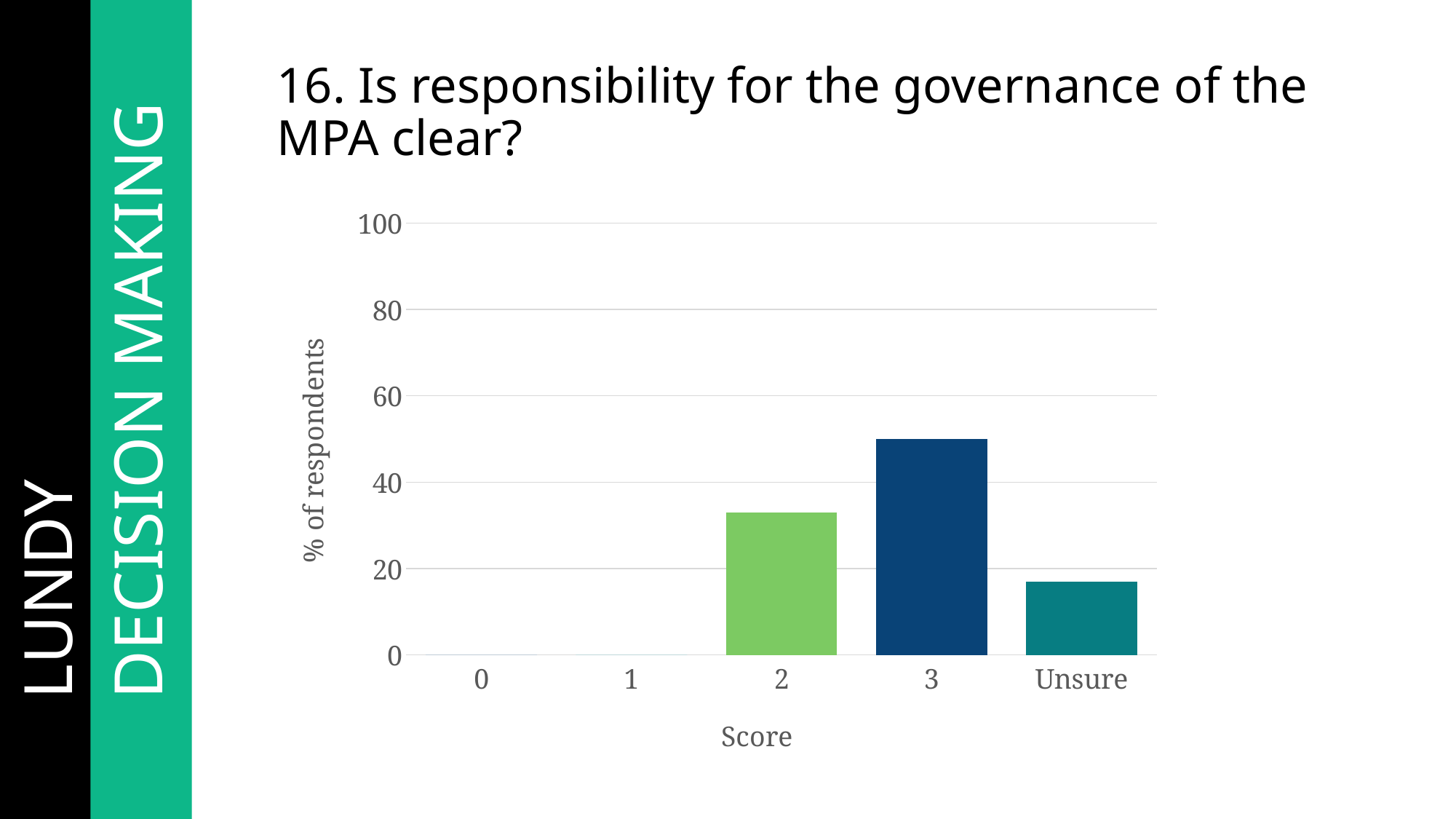
Which is larger, the value for score 2 or the value for Unsure? score 2 Is the value for score 3 greater or less than 60? less What is the label on the y axis? % of respondents Is the value for score 3 greater or less than 40? greater How many categories are shown on the x axis? 5 Is the value for Unsure greater or less than 20? less Among the categories with a visible bar, which has the lowest percentage of respondents? Unsure What kind of chart is shown on the slide? bar chart Which score category has the highest percentage of respondents? 3 Moving from score 0 to score 3 along the x axis, do the values rise or fall? rise